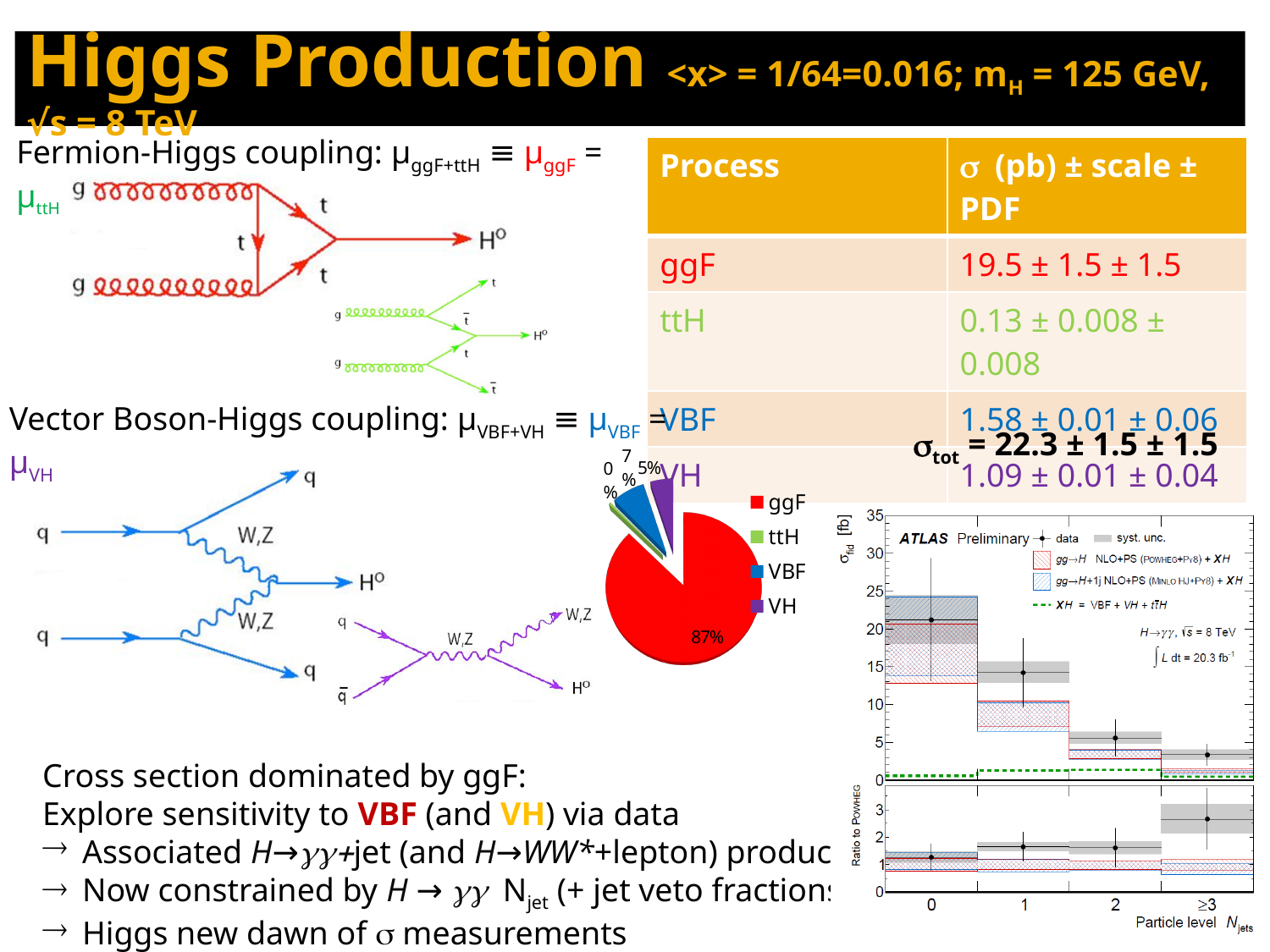
In the pie chart, what share of the pie is VH? 5% In the pie chart, which process has the largest slice? ggF In the pie chart, what share of the pie is VBF? 7% In the pie chart, what is the difference between the ggF share and the VBF share? 80% In the ATLAS Preliminary plot at the bottom right, how many particle-level N_jets bins are shown on the x axis? 4 In the pie chart, how many entries does the legend list? 4 What kind of chart is the chart with the ggF, ttH, VBF and VH legend? pie chart In the pie chart, which slice is larger, VBF or VH? VBF In the pie chart, what colour is the ggF slice? red In the pie chart, what share of the pie is ttH? 0% In the ATLAS Preliminary plot at the bottom right, do the data values rise or fall as N_jets increases? fall